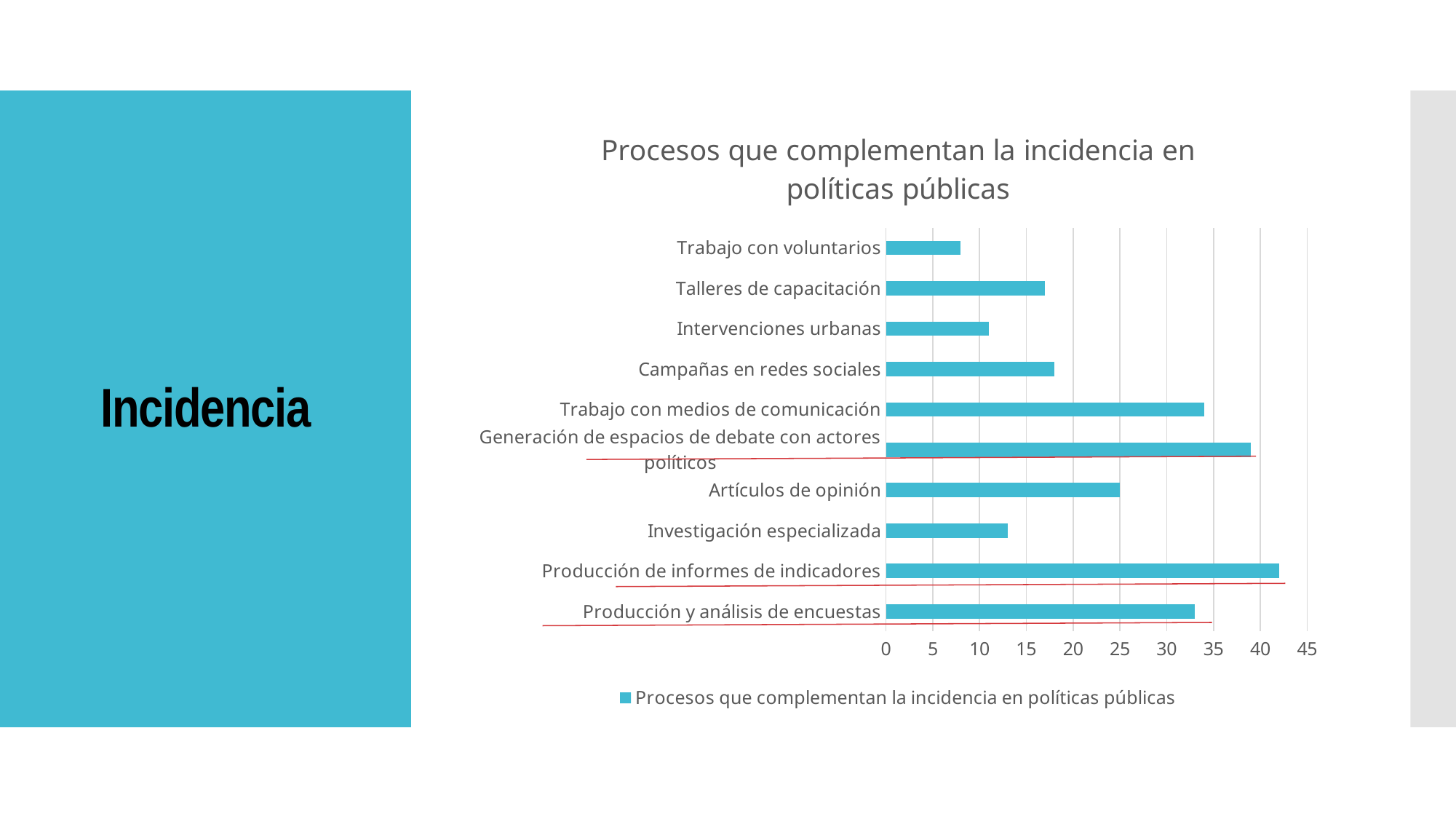
What kind of chart is shown on the slide? Bar chart What is the title of the chart? Procesos que complementan la incidencia en políticas públicas Is the value for Trabajo con medios de comunicación greater or less than 30? greater Which category has the lowest value? Trabajo con voluntarios Is the value for Trabajo con voluntarios greater or less than 10? less Is the value for Artículos de opinión greater or less than 20? greater Which category has the highest value? Producción de informes de indicadores How many categories are plotted in the chart? 10 Which is larger, the value for Generación de espacios de debate con actores políticos or the value for Trabajo con medios de comunicación? Generación de espacios de debate con actores políticos How many series does the legend list? 1 Which is larger, the value for Artículos de opinión or the value for Investigación especializada? Artículos de opinión